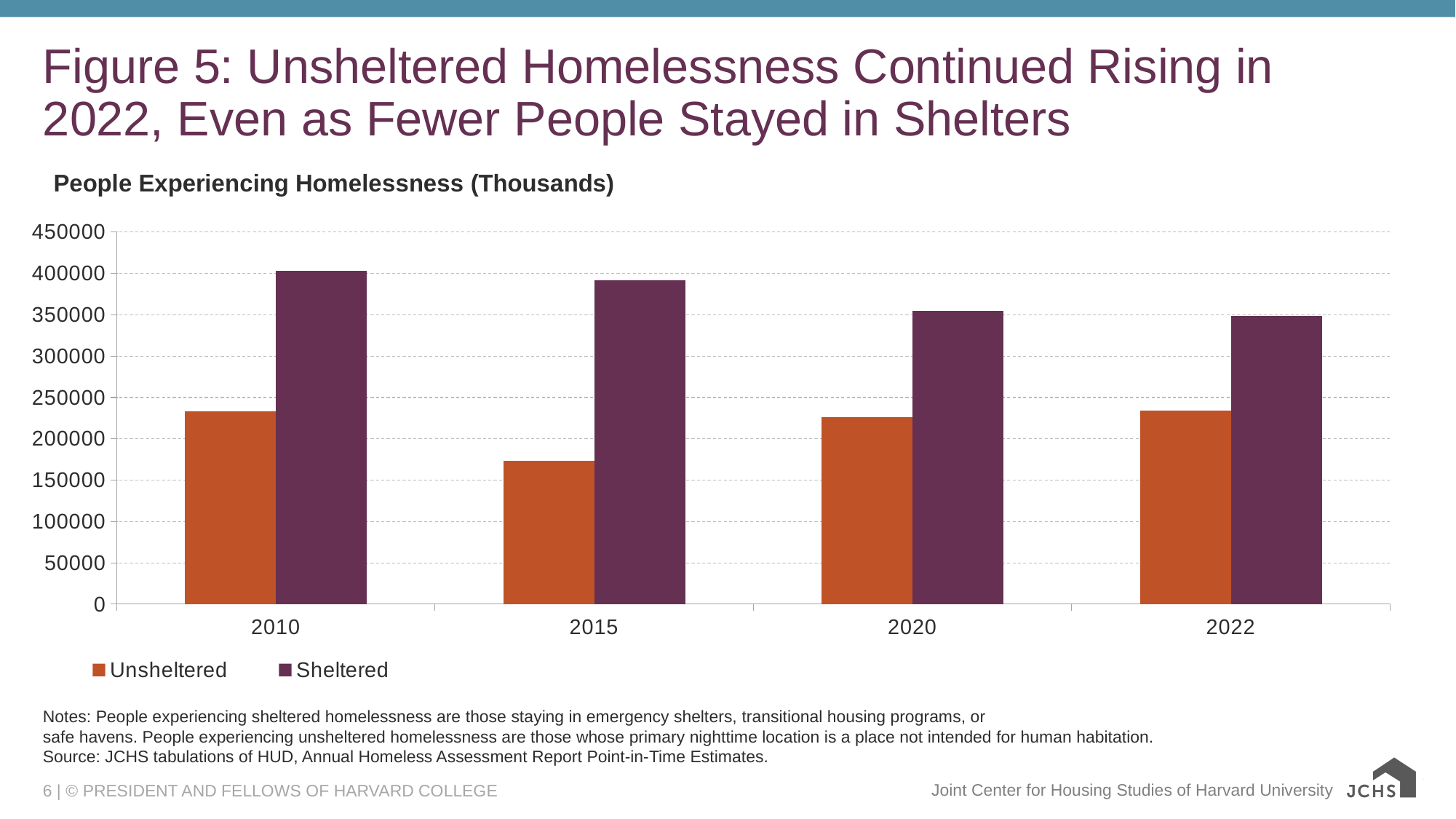
In which year is the Sheltered value highest? 2010 Do the Sheltered values rise or fall from 2010 to 2022? fall How many years are shown on the x axis? 4 Is the Unsheltered value for 2015 greater or less than 200000? less What kind of chart is shown on the slide? bar chart What colour are the Unsheltered bars? orange In which year is the Unsheltered value lowest? 2015 How many series does the legend list? 2 Is the Sheltered value for 2015 greater or less than 400000? less In 2022, which is larger, the Sheltered value or the Unsheltered value? Sheltered Is the Unsheltered value for 2020 greater or less than 250000? less